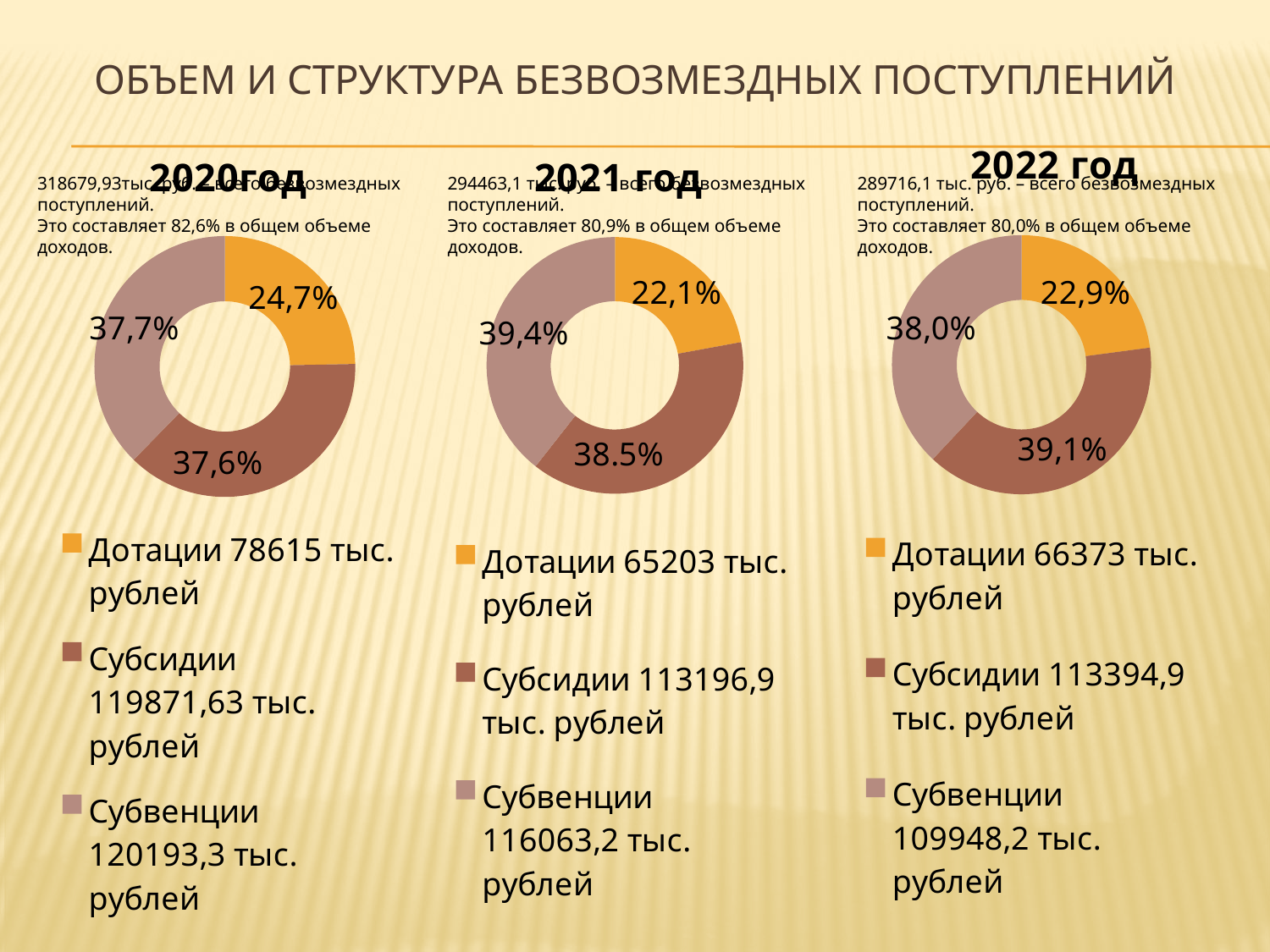
How many doughnut charts are shown on the slide? 3 In the 2022 год chart, what percentage share is shown for Субсидии? 39,1% According to the legend of the 2020 год chart, what amount is given for Субвенции? 120193,3 тыс. рублей What type of chart is used for the 2020 год data? Doughnut chart How many categories does each doughnut chart on the slide show? 3 In the 2022 год chart, which is larger: the share for Субсидии or the share for Дотации? Субсидии In the 2020 год chart, what percentage share is shown for Дотации? 24,7% In the 2022 год chart, which category has the smallest share? Дотации According to the legend of the 2022 год chart, what amount is given for Дотации? 66373 тыс. рублей In the 2021 год chart, what percentage share is shown for Субвенции? 39,4% In the 2021 год chart, what is the difference in percentage points between the Субвенции share and the Дотации share? 17,3 In the 2021 год chart, which category has the largest share? Субвенции